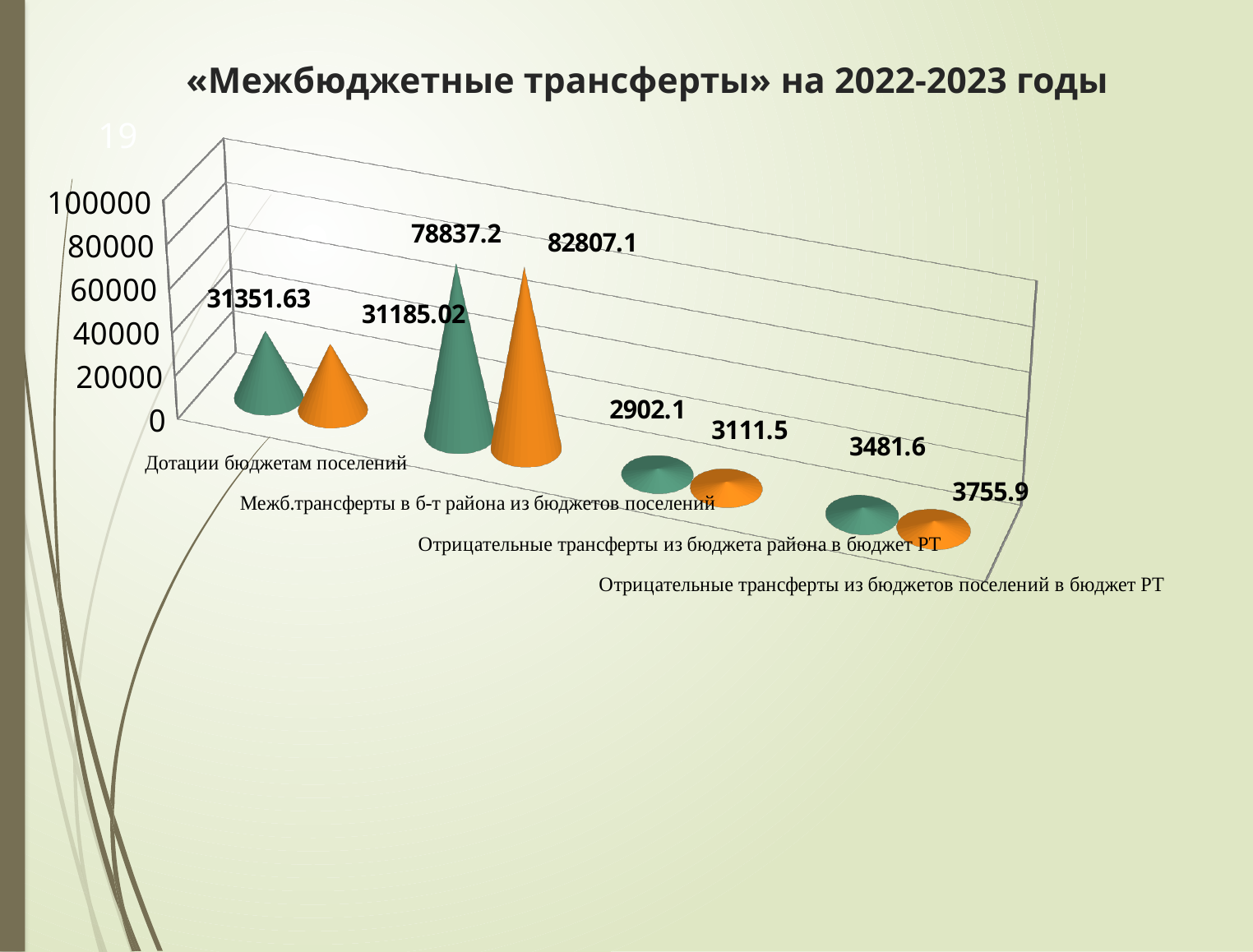
What is the value of the orange bar for «Дотации бюджетам поселений»? 31185.02 What is the value of the green bar for «Дотации бюджетам поселений»? 31351.63 What is the value of the orange bar for «Отрицательные трансферты из бюджетов поселений в бюджет РТ»? 3755.9 For «Отрицательные трансферты из бюджета района в бюджет РТ», which is larger: the green bar or the orange bar? the orange bar What kind of chart is shown on the slide? bar chart How many categories are shown on the x axis? 4 Which category has the highest orange bar? Межб.трансферты в б-т района из бюджетов поселений Which category has the lowest green bar? Отрицательные трансферты из бюджета района в бюджет РТ What is the value of the green bar for «Межб.трансферты в б-т района из бюджетов поселений»? 78837.2 What is the value of the orange bar for «Межб.трансферты в б-т района из бюджетов поселений»? 82807.1 What is the title of the chart? «Межбюджетные трансферты» на 2022-2023 годы What is the difference between the orange and green bars for «Межб.трансферты в б-т района из бюджетов поселений»? 3969.9